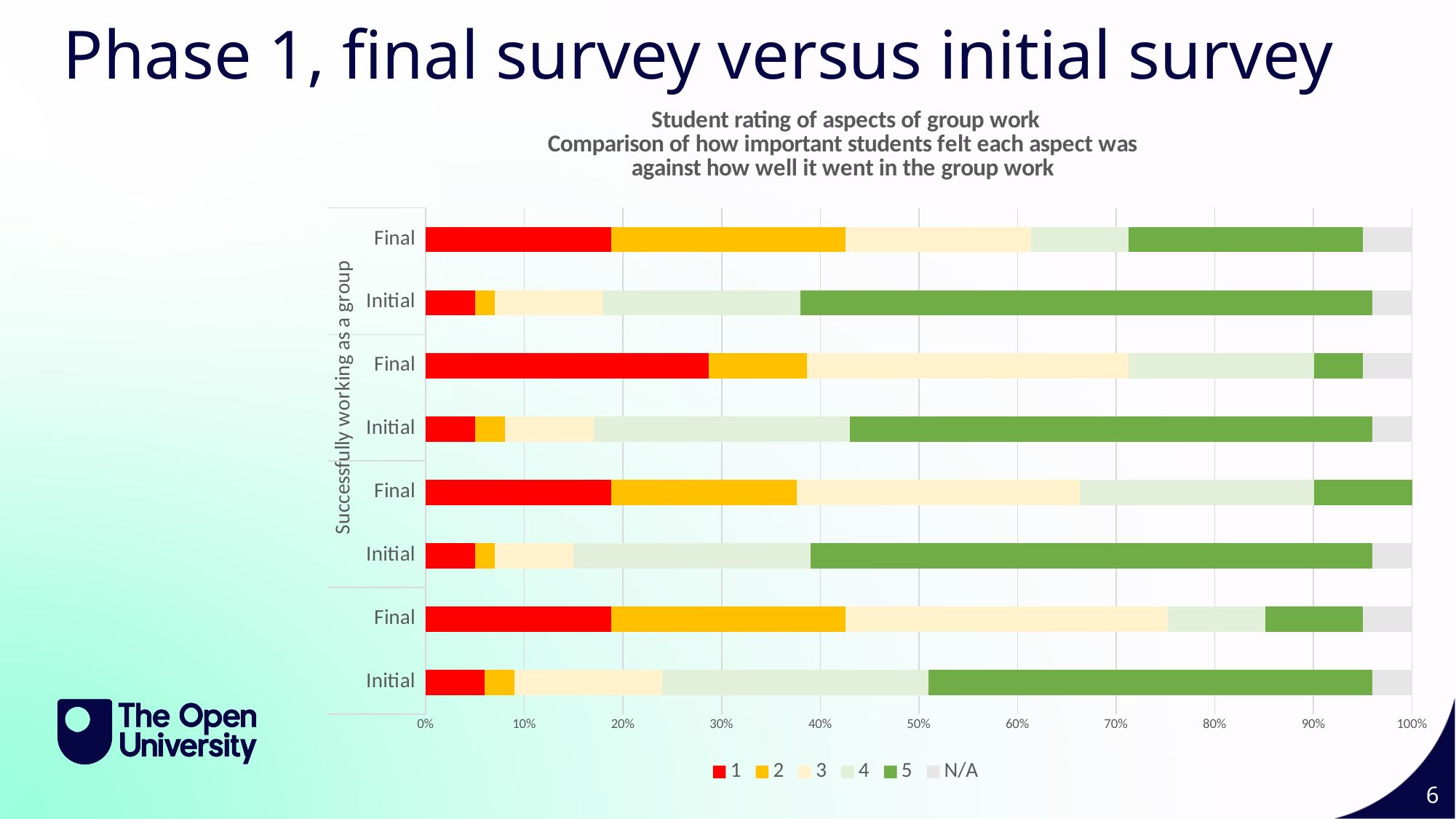
What is the maximum value shown on the horizontal axis? 100% In the topmost Final bar, is the share rated 5 (green) greater or less than 30%? less Which has the larger share rated 1 (red): the topmost Final bar or the topmost Initial bar? Final What are the legend entries of the chart? 1, 2, 3, 4, 5, N/A In the topmost Final bar, is the share rated 1 (red) greater or less than 10%? greater What kind of chart is shown on the slide? Stacked bar chart What is the first line of the chart's title? Student rating of aspects of group work How many bars are plotted in the chart? 8 How many series does the chart's legend list? 6 In the bottommost Initial bar, is the share rated 1 (red) greater or less than 10%? less Which has the larger share rated 5 (green): the bottommost Final bar or the bottommost Initial bar? Initial